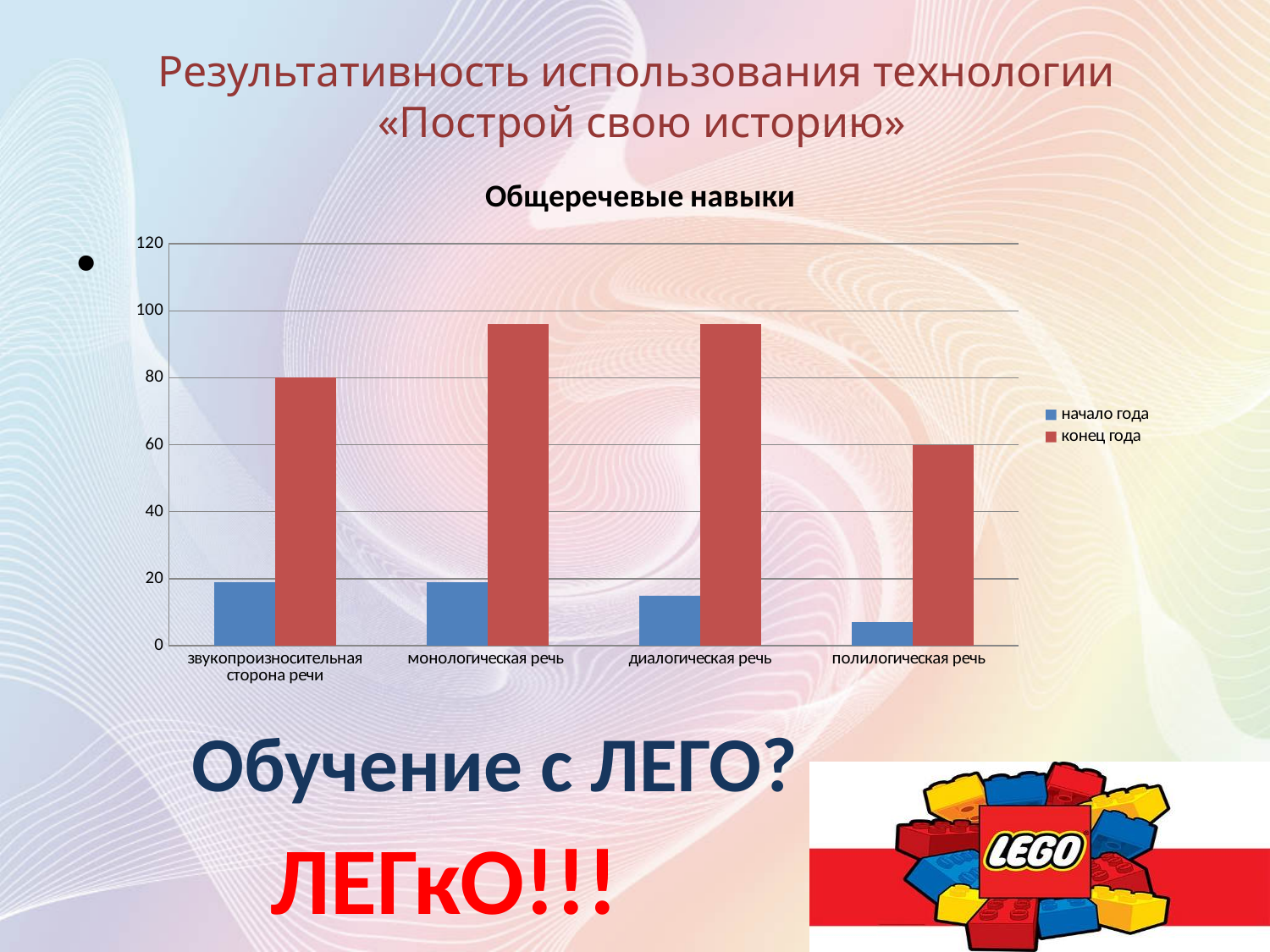
How many categories are shown on the x axis of the chart? 4 Which is larger for 'диалогическая речь': 'начало года' or 'конец года'? конец года Which category has the lowest 'начало года' value? полилогическая речь How many series does the chart legend list? 2 What is the value of 'конец года' for 'полилогическая речь'? 60 Which colour represents the 'конец года' series in the chart? red Is the value of 'конец года' for 'монологическая речь' greater or less than 80? greater What kind of chart is shown on the slide? bar chart Is the value of 'начало года' for 'полилогическая речь' greater or less than 20? less Which category has the lowest 'конец года' value? полилогическая речь What is the value of 'конец года' for 'звукопроизносительная сторона речи'? 80 What is the title of the chart? Общеречевые навыки